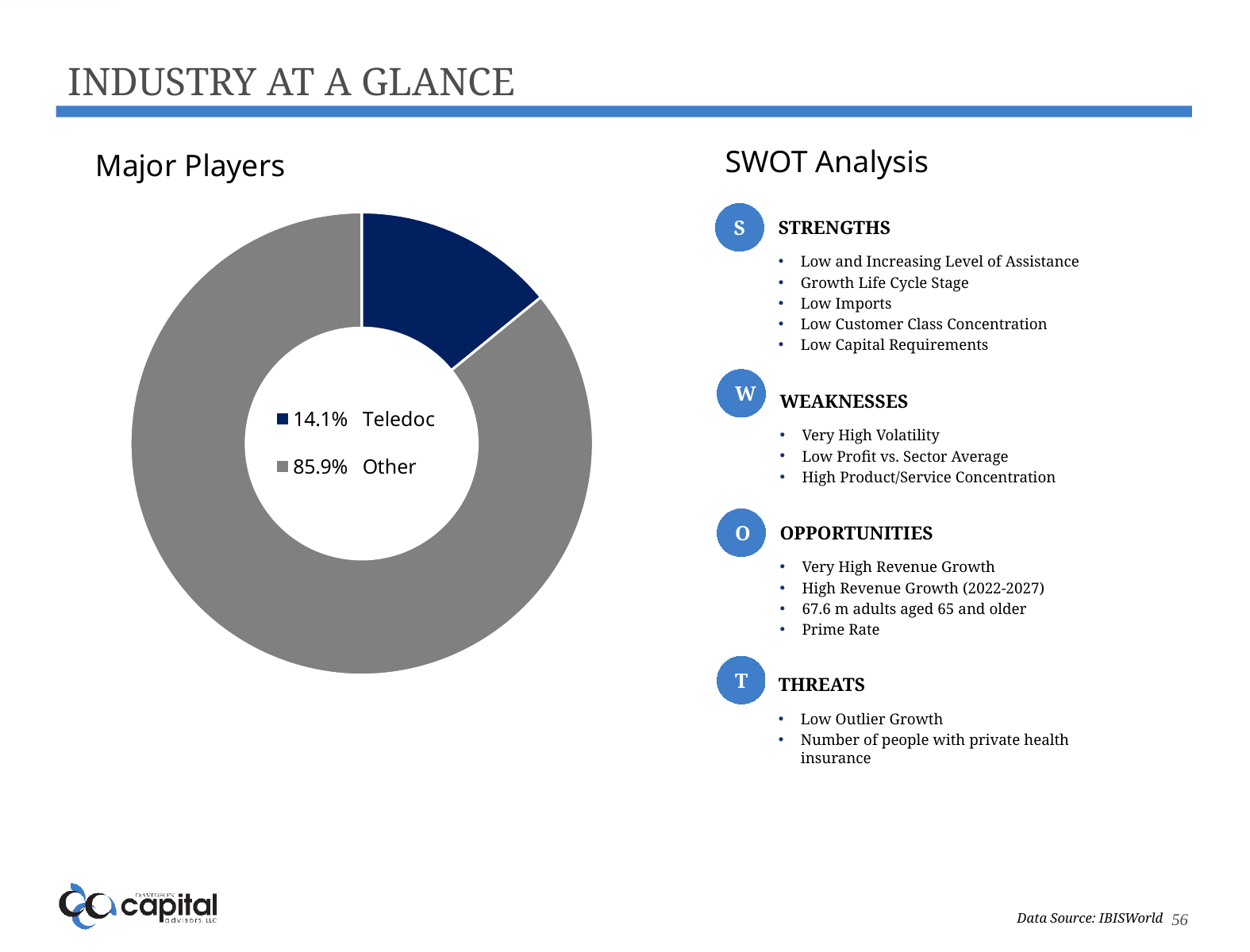
In the Major Players chart, which is larger: Teledoc or Other? Other Which segment of the Major Players chart is the largest? Other How many segments does the Major Players chart have? 2 What kind of chart is shown under "Major Players"? Doughnut (pie) chart What is the difference in percentage points between the Other and Teledoc segments in the Major Players chart? 71.8 What share of the Major Players chart does Teledoc hold? 14.1% What colour is the Teledoc segment in the Major Players chart? Dark blue What is the title of the chart on the left of the slide? Major Players Which segment of the Major Players chart is the smallest? Teledoc What share of the Major Players chart is labelled Other? 85.9% What is the combined total of the two segments in the Major Players chart? 100%